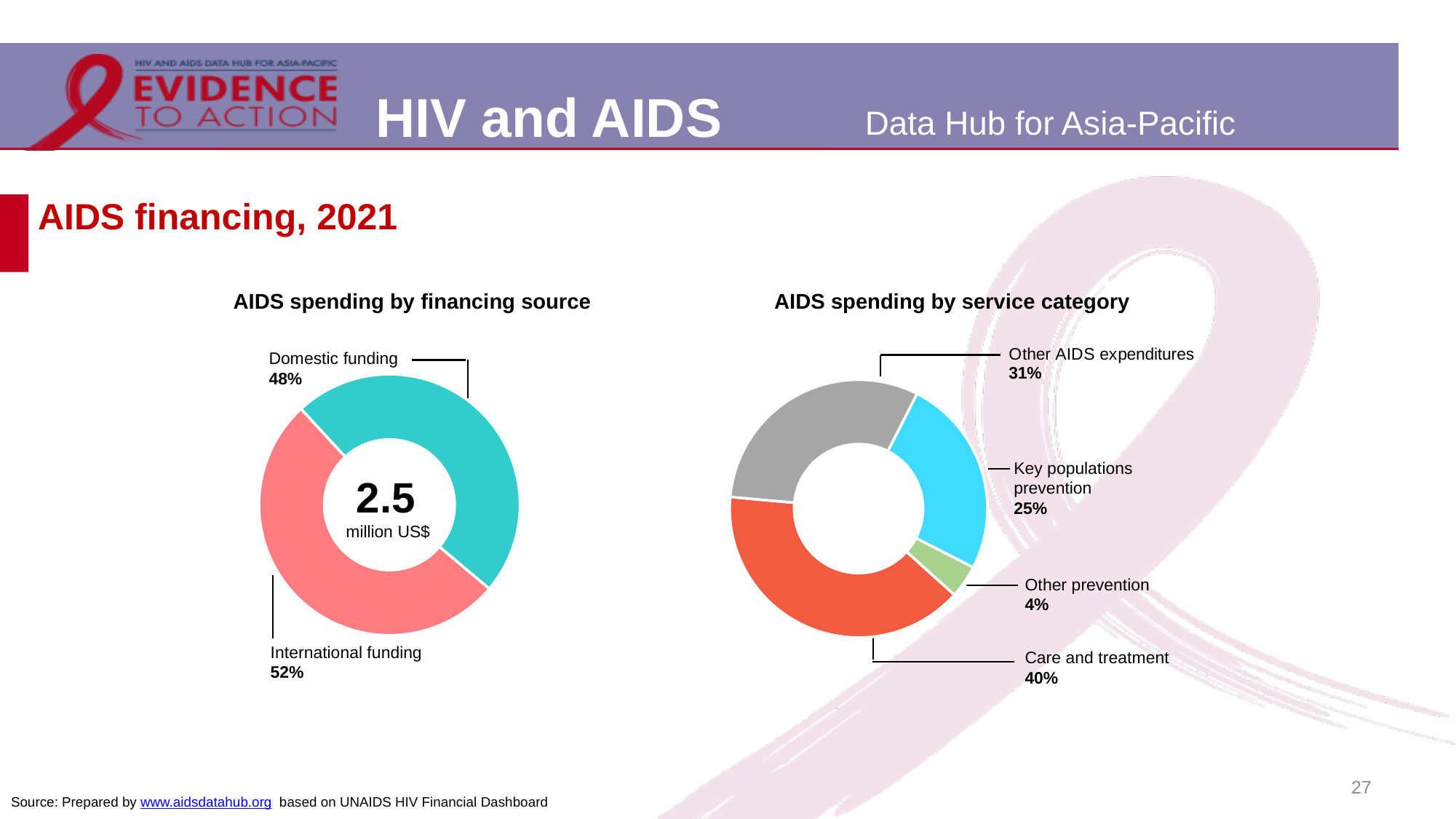
How many service categories are shown in the 'AIDS spending by service category' chart? 4 In the 'AIDS spending by service category' chart, which service category has the largest share? Care and treatment In the 'AIDS spending by service category' chart, what share is Key populations prevention? 25% In the 'AIDS spending by financing source' chart, which financing source has the larger share? International funding In the 'AIDS spending by financing source' chart, what share is Domestic funding? 48% What kind of chart is 'AIDS spending by financing source'? Donut (pie) chart In the 'AIDS spending by financing source' chart, what share is International funding? 52% In the 'AIDS spending by financing source' chart, what is the difference in percentage points between International funding and Domestic funding? 4 percentage points In the 'AIDS spending by service category' chart, which service category has the smallest share? Other prevention In the 'AIDS spending by service category' chart, what is the difference in percentage points between Other AIDS expenditures and Key populations prevention? 6 percentage points In the 'AIDS spending by financing source' chart, what total amount is shown in the centre of the donut? 2.5 million US$ In the 'AIDS spending by service category' chart, what share is Care and treatment? 40%